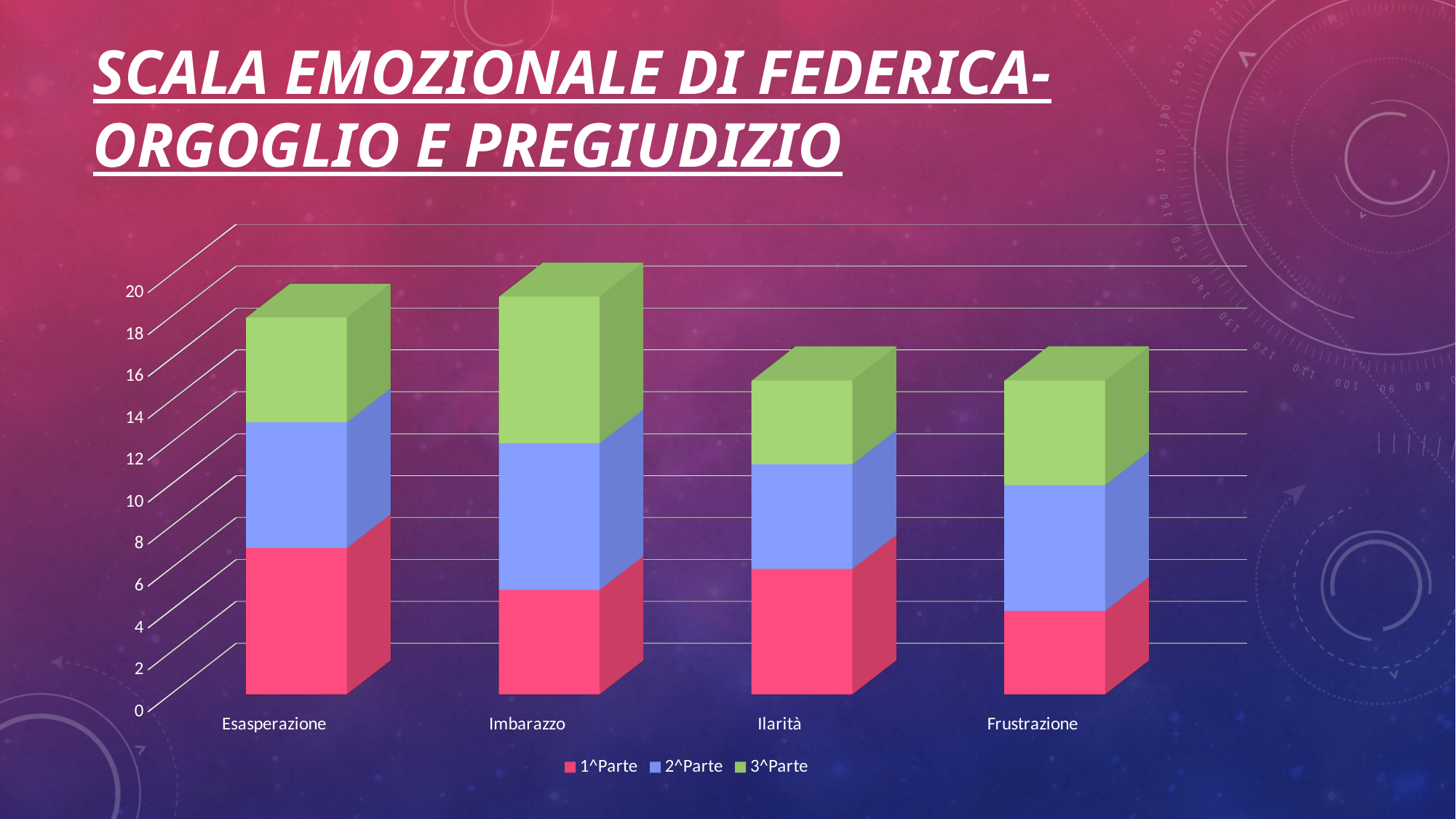
Which series is shown in green in the chart? 3^Parte How many categories are shown on the x axis of the chart? 4 Which is larger, the 2^Parte value for Imbarazzo or the 2^Parte value for Ilarità? Imbarazzo What are the three series names listed in the chart's legend? 1^Parte, 2^Parte, 3^Parte What kind of chart is shown on the slide? Stacked bar chart Is the total stacked value for Esasperazione greater or less than 16? greater Is the total stacked value for Frustrazione greater or less than 18? less How many series does the chart's legend list? 3 Is the 1^Parte value for Frustrazione greater or less than 8? less Which is larger, the 1^Parte value for Esasperazione or the 1^Parte value for Frustrazione? Esasperazione Which category has the tallest stacked bar overall? Imbarazzo